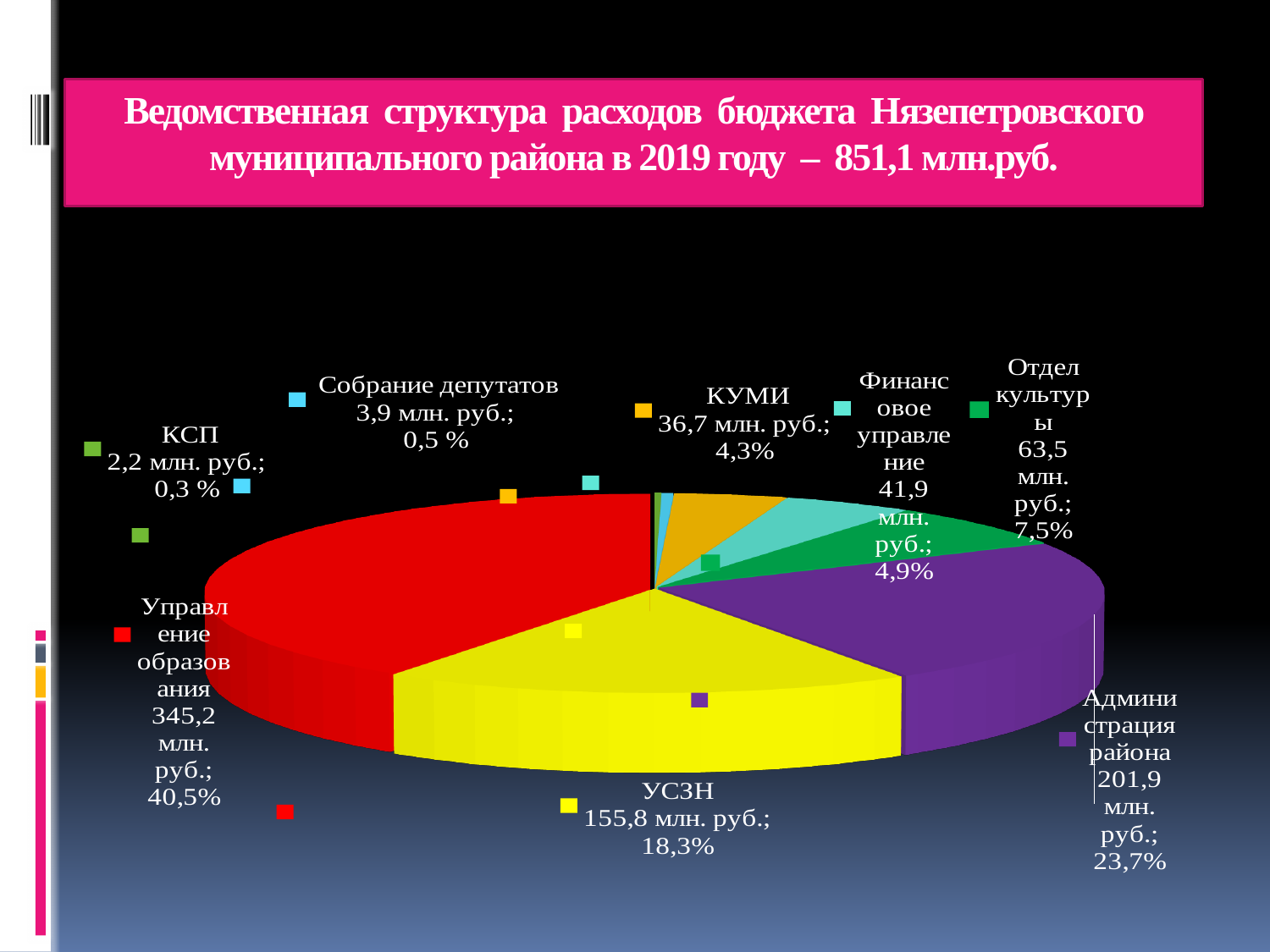
What is the value for УСЗН? 155,8 млн. руб. Which is larger, Финансовое управление or КУМИ? Финансовое управление What kind of chart is shown on the slide? Pie chart Which category has the largest slice? Управление образования What is the value for Собрание депутатов? 3,9 млн. руб. What share of the pie does Отдел культуры have? 7,5% What total budget amount is stated in the chart title? 851,1 млн.руб. What share of the pie does Администрация района have? 23,7% How many slices does the pie chart have? 8 What is the difference in млн. руб. between Администрация района and УСЗН? 46,1 млн. руб. What is the value for Управление образования? 345,2 млн. руб. Which category has the smallest slice? КСП